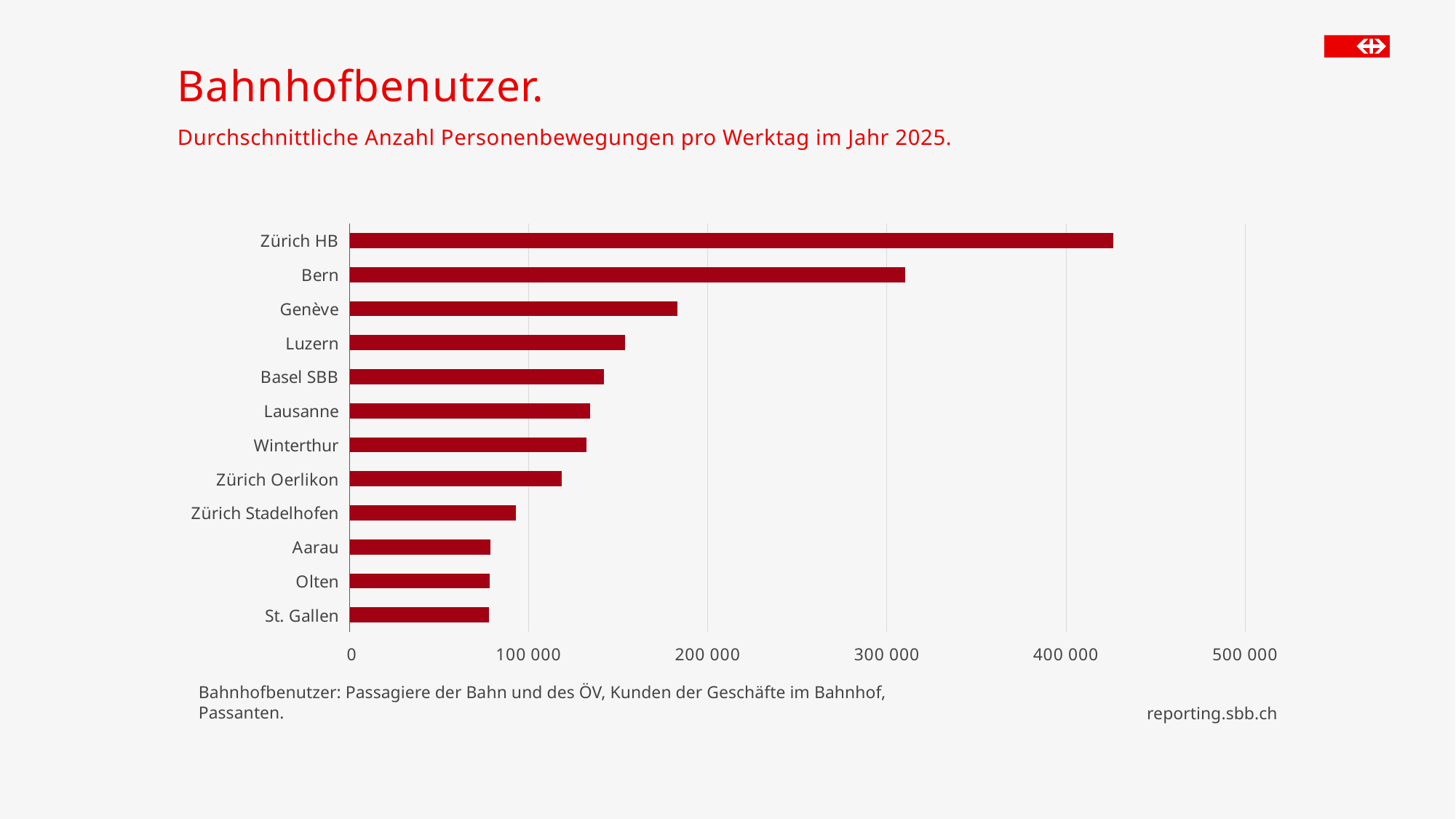
Which year does the chart's subtitle refer to? 2025 What is the title of the chart on the slide? Bahnhofbenutzer. Which has a larger value, Bern or Genève? Bern How many stations are listed in the chart? 12 What kind of chart is shown on the slide? bar chart Which station has the highest number of Personenbewegungen pro Werktag? Zürich HB Is the value for Zürich Stadelhofen greater or less than 100 000? less Which has a larger value, Zürich Oerlikon or Zürich Stadelhofen? Zürich Oerlikon Is the value for Genève greater or less than 200 000? less Is the value for Bern greater or less than 300 000? greater